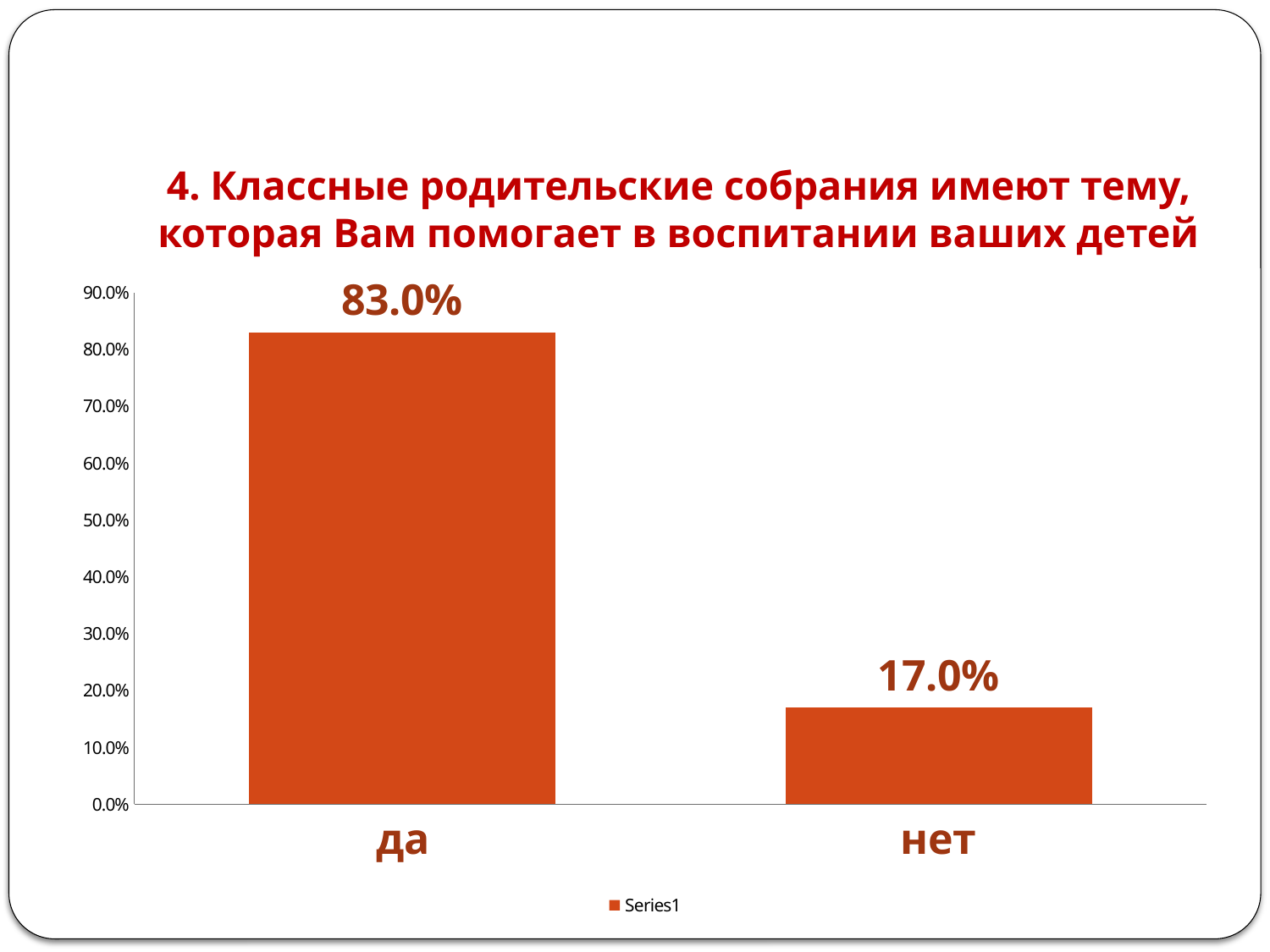
Which category has the lowest value? нет Is the value for "нет" greater or less than 20.0%? less Is the value for "да" greater or less than 80.0%? greater What is the name of the series shown in the legend? Series1 What is the difference between the values for "да" and "нет"? 66.0% Which is larger, the value for "да" or the value for "нет"? да What is the value for "да"? 83.0% Which category has the highest value? да How many series does the legend list? 1 What kind of chart is shown on the slide? bar chart How many categories are shown on the x axis? 2 What is the value for "нет"? 17.0%